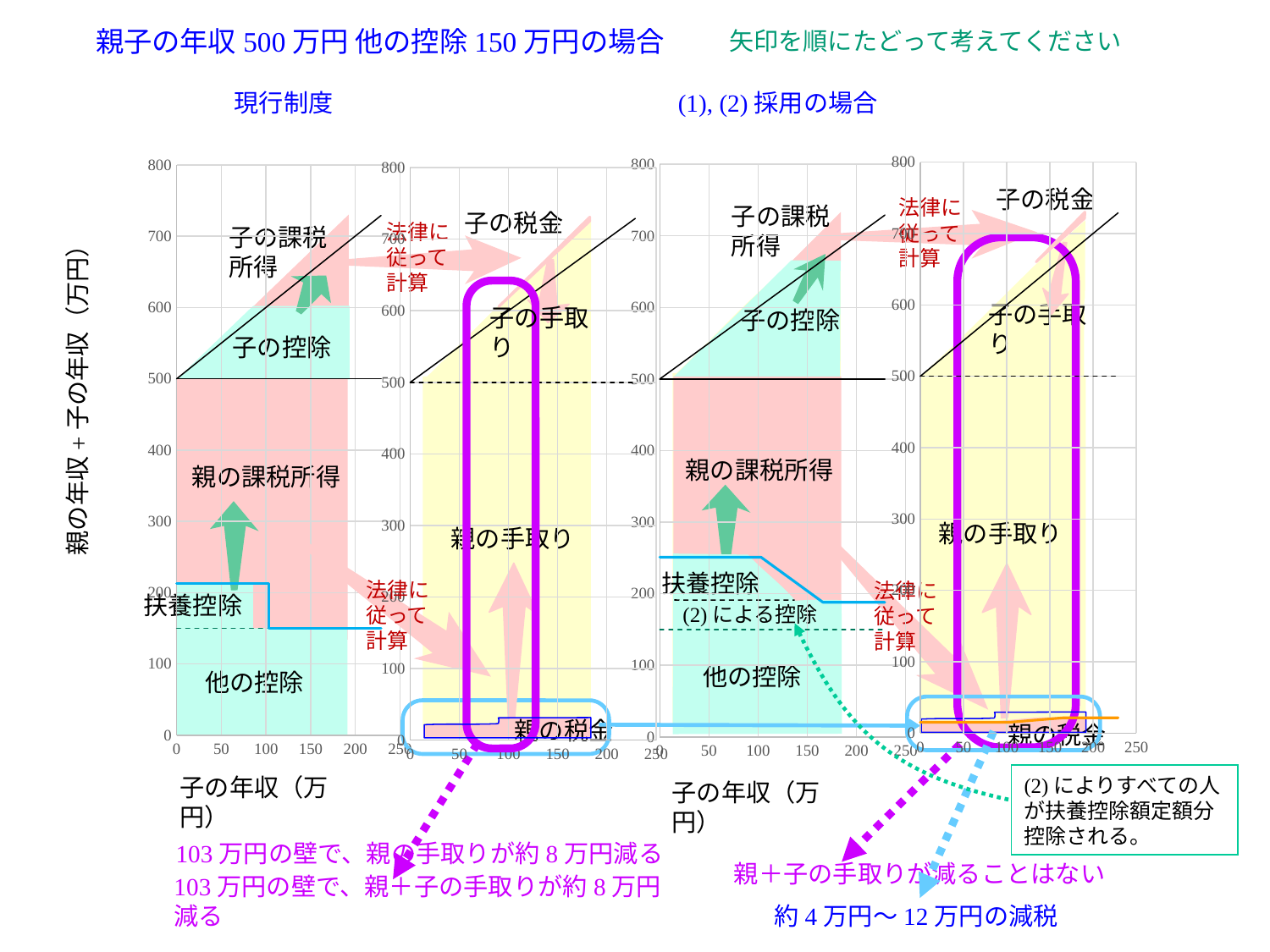
In the third chart from the left (under (1), (2) 採用の場合), is the 扶養控除 line at 子の年収 200 greater or less than 200? less In the leftmost chart (under 現行制度), is the 扶養控除 line at 子の年収 0 greater or less than 100? greater What is the x-axis title of the leftmost chart? 子の年収（万円） In the leftmost chart (under 現行制度), is the top of the 他の控除 area at 子の年収 150 greater or less than 200? less What kind of chart is the leftmost chart (under 現行制度)? area chart How many charts are shown under the heading 現行制度? 2 How many charts are shown on the slide? 4 What is the highest tick value on the y-axis of the leftmost chart? 800